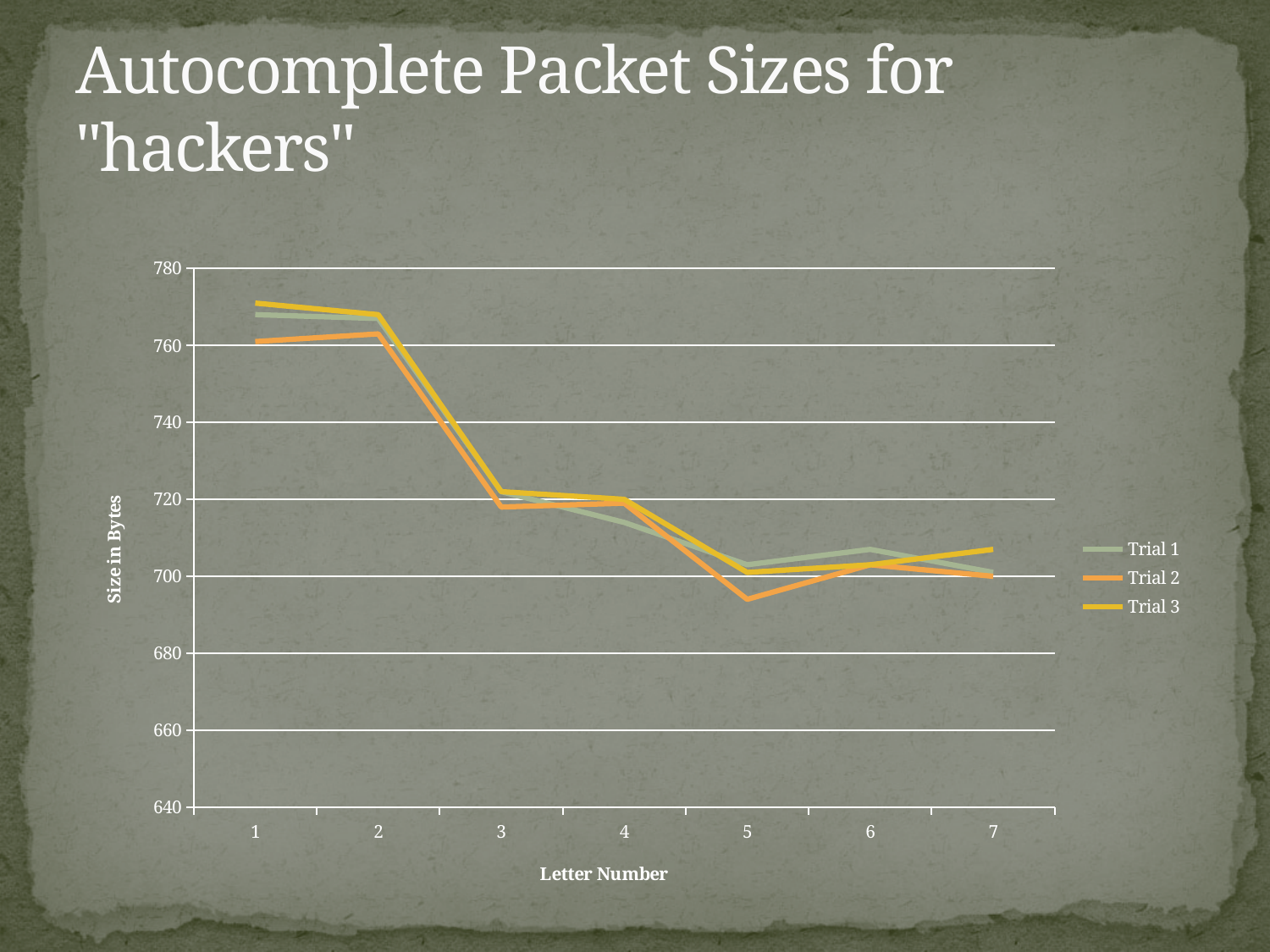
What is the title of the y axis? Size in Bytes Do the packet sizes generally rise or fall as the letter number increases from 1 to 7? Fall Which series has the lowest value at letter number 5? Trial 2 Is the value for Trial 1 at letter number 3 greater or less than 740? less Is the value for Trial 3 at letter number 1 greater or less than 760? greater At letter number 1, which is larger: Trial 3 or Trial 2? Trial 3 How many letter numbers are plotted along the x axis? 7 How many series does the legend list? 3 Is the value for Trial 2 at letter number 5 greater or less than 700? less What kind of chart is shown on the slide? Line chart At which letter number does Trial 2 reach its lowest value? 5